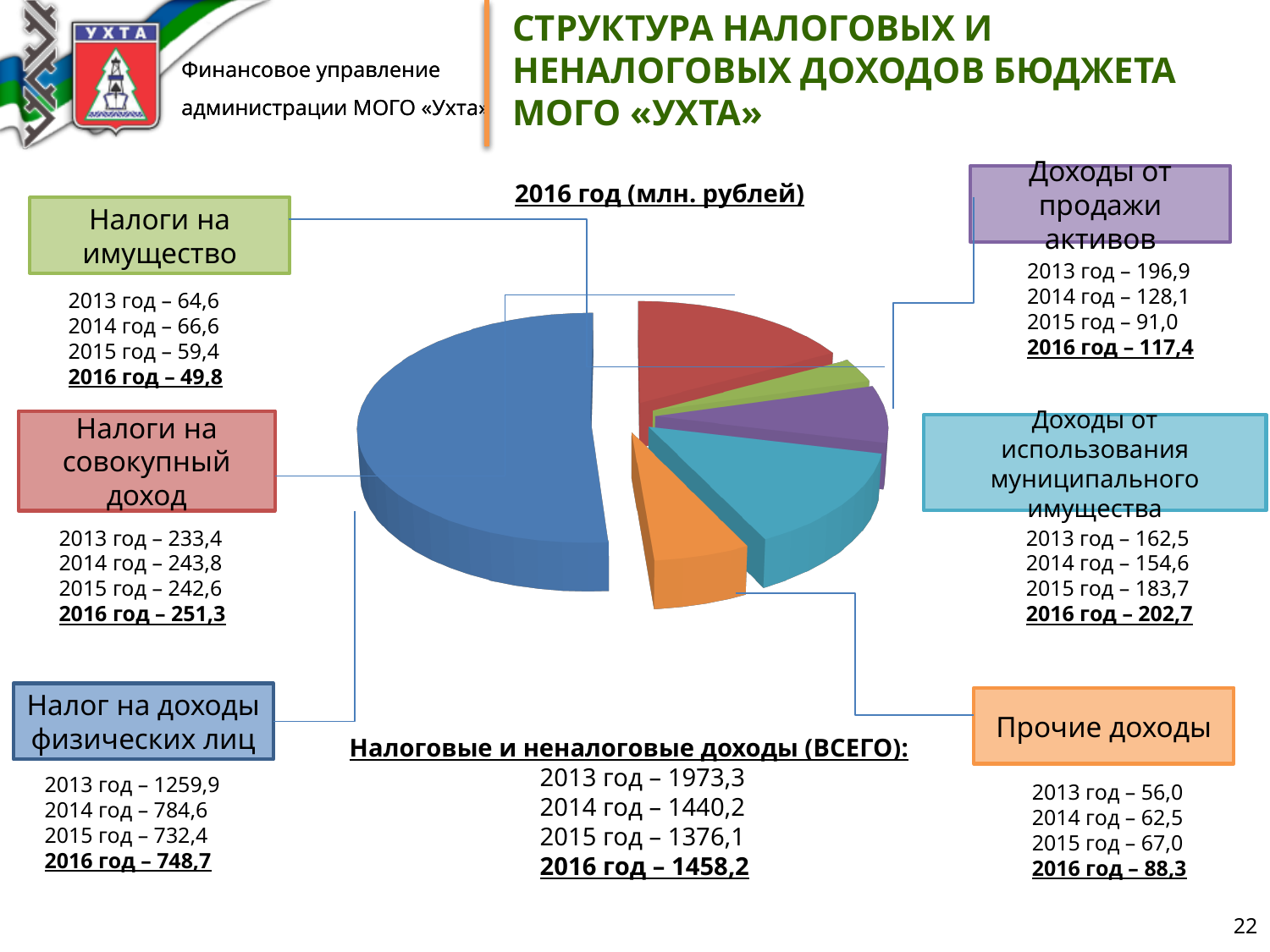
Which category has the largest slice in the 2016 pie chart? Налог на доходы физических лиц What is the 2016 value for Налоги на имущество? 49,8 What is the difference between the 2016 values for Доходы от использования муниципального имущества and Доходы от продажи активов? 85,3 Which category has the smallest slice in the 2016 pie chart? Налоги на имущество Which is larger in 2016: Налоги на совокупный доход or Доходы от продажи активов? Налоги на совокупный доход What unit is stated in the chart title for the 2016 pie chart? млн. рублей What is the total of Налоговые и неналоговые доходы for 2016? 1458,2 What is the 2016 value for Прочие доходы? 88,3 What is the 2016 value for Доходы от использования муниципального имущества? 202,7 How many categories (slices) does the pie chart have? 6 What is the 2016 value for Налог на доходы физических лиц? 748,7 What kind of chart is shown on the slide? pie chart